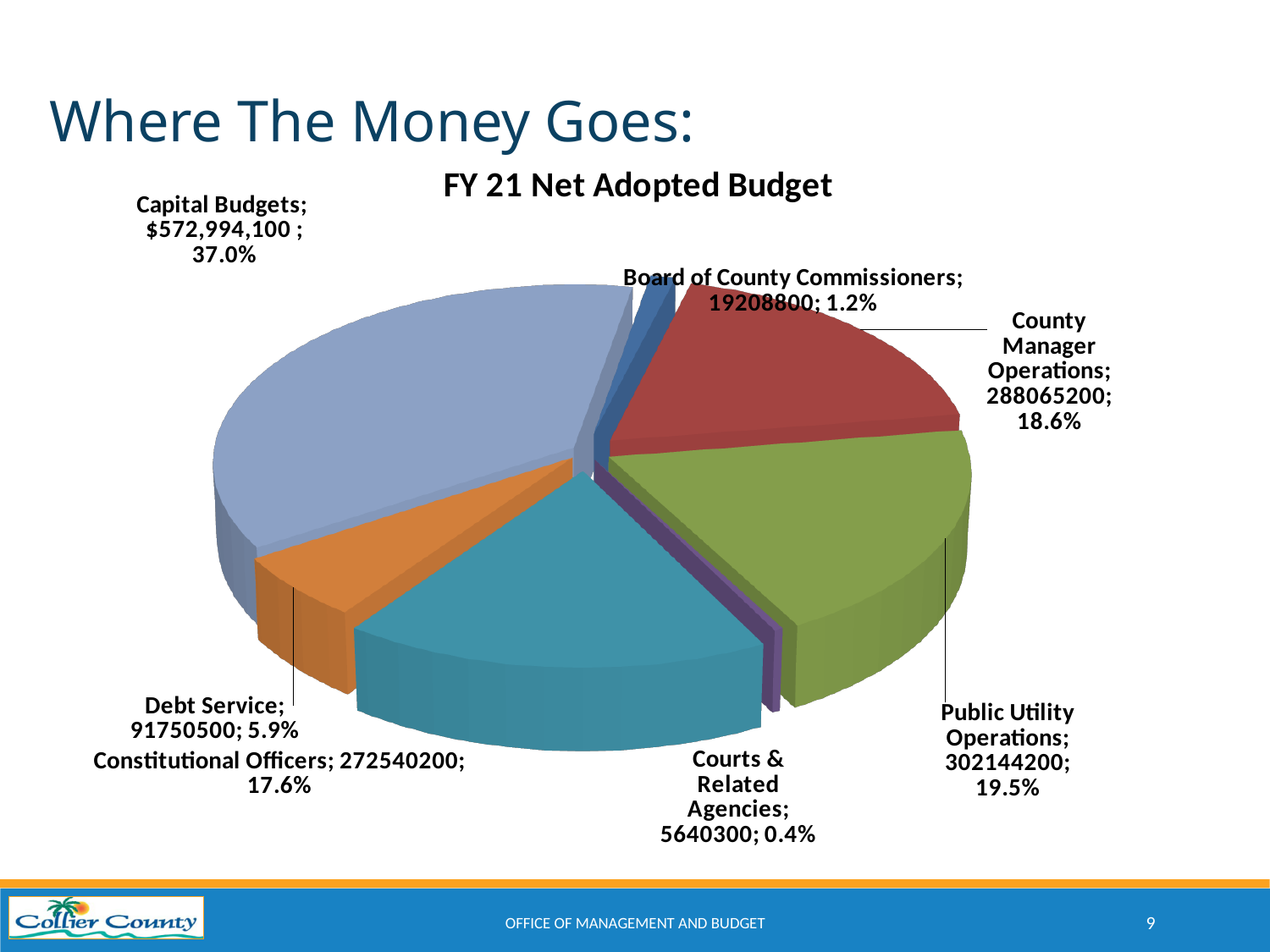
What percentage of the pie does Public Utility Operations represent? 19.5% What is the value shown for County Manager Operations? 288065200 What is the value shown for Board of County Commissioners? 19208800 What kind of chart is shown on the slide? Pie chart What percentage of the pie does Debt Service represent? 5.9% What is the value shown for Capital Budgets? $572,994,100 How many categories are shown in the pie chart? 7 Which category has the largest slice of the pie? Capital Budgets What is the title of the chart? FY 21 Net Adopted Budget Which category has the smallest slice of the pie? Courts & Related Agencies Which is larger, Public Utility Operations or Constitutional Officers? Public Utility Operations What is the difference in percentage points between Public Utility Operations (19.5%) and County Manager Operations (18.6%)? 0.9